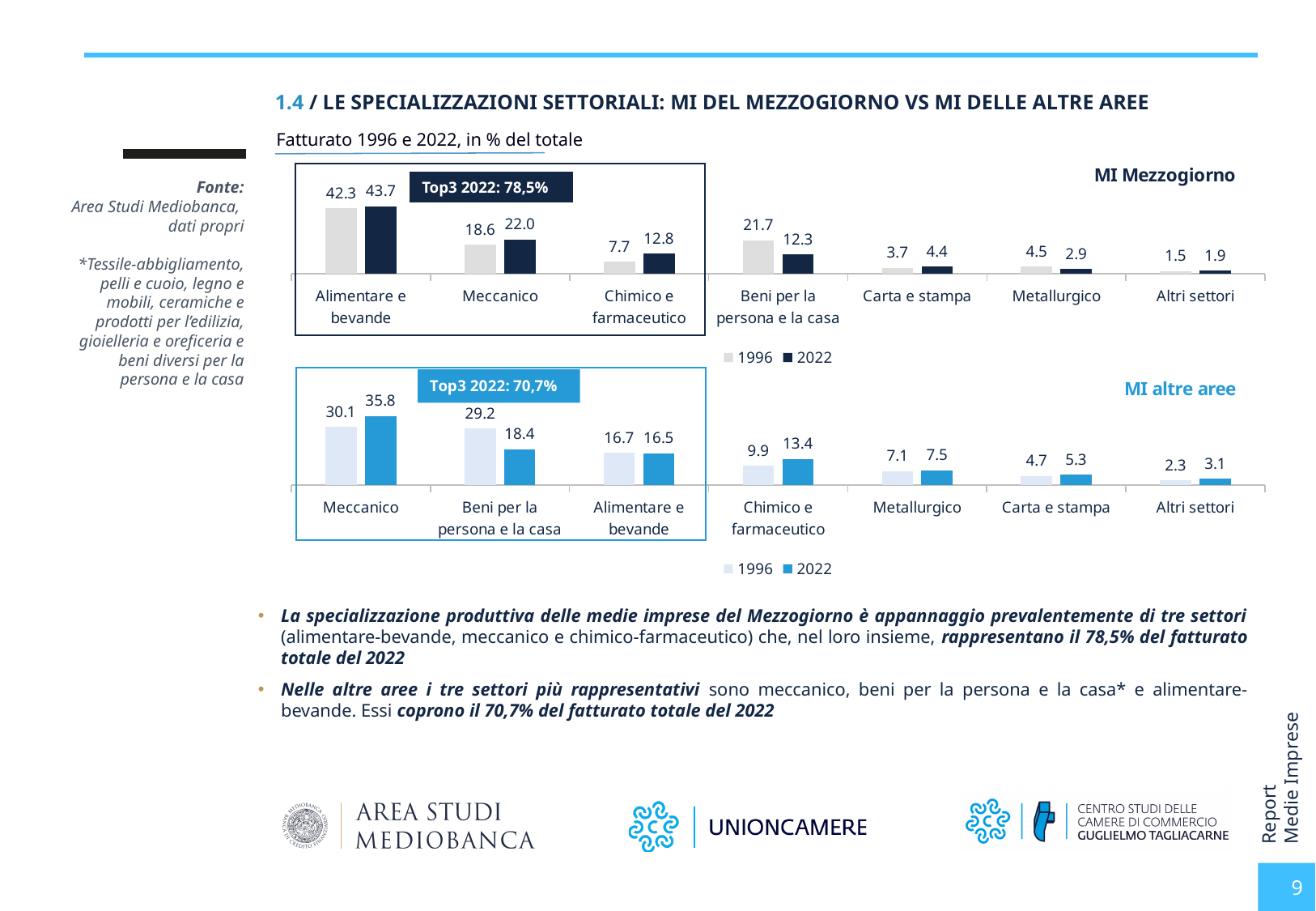
In the MI Mezzogiorno chart, is the 1996 value for Metallurgico larger or smaller than its 2022 value? larger What Top3 2022 share is shown in the box on the MI altre aree chart? 70,7% In the MI altre aree chart, what is the difference between the 1996 and 2022 values for Beni per la persona e la casa? 10.8 In the MI altre aree chart, which category has the highest 1996 value? Meccanico How many series does the legend of the MI altre aree chart list? 2 In the MI altre aree chart, how many categories are shown on the x axis? 7 In the MI Mezzogiorno chart, what is the difference between the 2022 and 1996 values for Chimico e farmaceutico? 5.1 In the MI Mezzogiorno chart, which category has the lowest 2022 value? Altri settori What type of chart is the MI Mezzogiorno chart? Bar chart In the MI Mezzogiorno chart, what is the 1996 value for Beni per la persona e la casa? 21.7 In the MI altre aree chart, what is the 2022 value for Meccanico? 35.8 In the MI Mezzogiorno chart, what is the 2022 value for Alimentare e bevande? 43.7